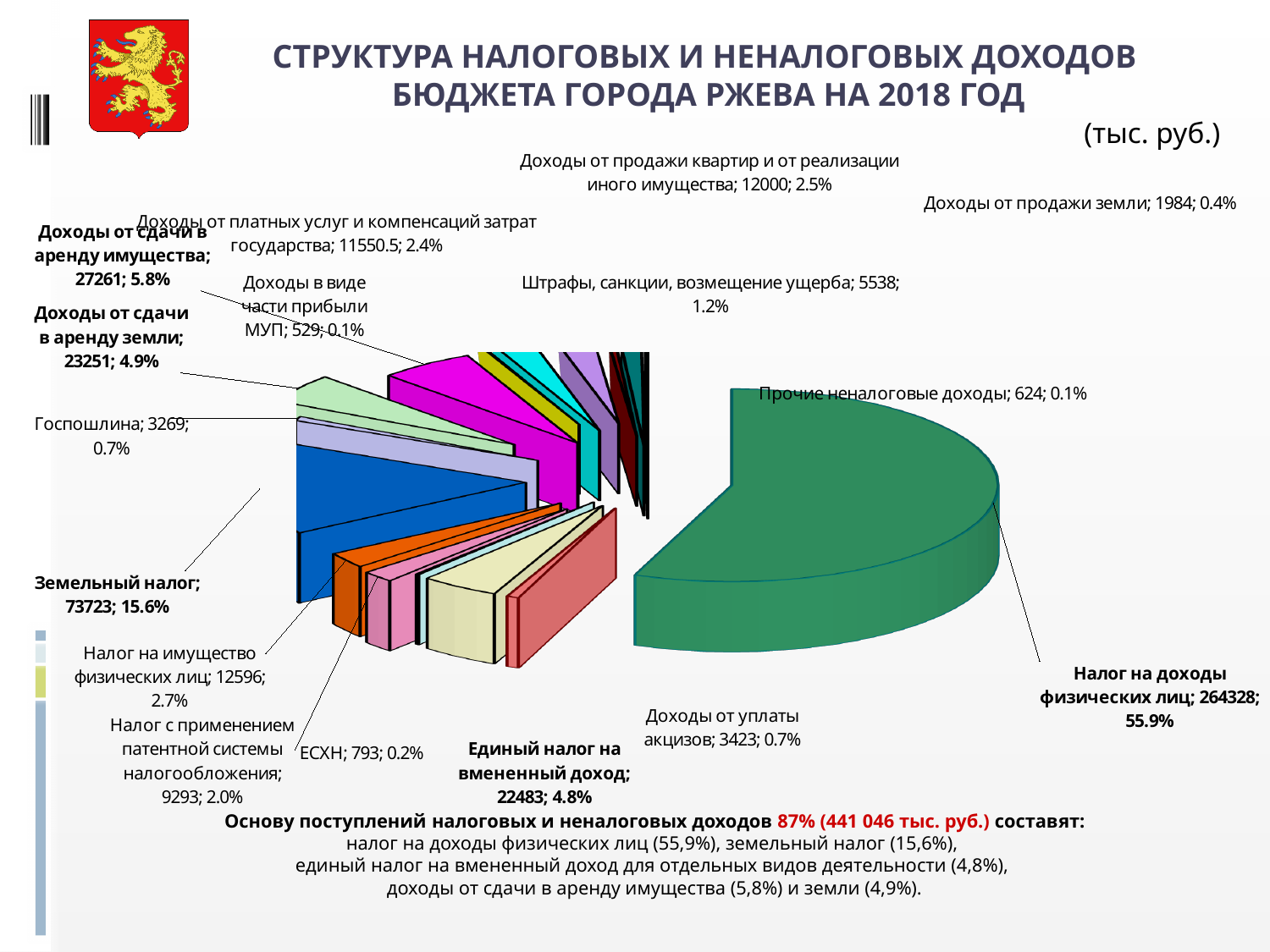
Which is larger: Единый налог на вмененный доход or Налог на имущество физических лиц? Единый налог на вмененный доход Which category has the largest share of the pie? Налог на доходы физических лиц What kind of chart is shown on the slide? pie chart What is the value for Доходы от сдачи в аренду земли? 23251 In what units are the values on the chart given? тыс. руб. How many categories are shown in the pie chart? 16 What is the value for Налог на доходы физических лиц? 264328 What share of the pie does Штрафы, санкции, возмещение ущерба represent? 1.2% Which category has the smallest value? Доходы в виде части прибыли МУП What is the difference between the values for Доходы от сдачи в аренду имущества and Доходы от сдачи в аренду земли? 4010 What share of the pie does Земельный налог represent? 15.6% What is the value for Госпошлина? 3269